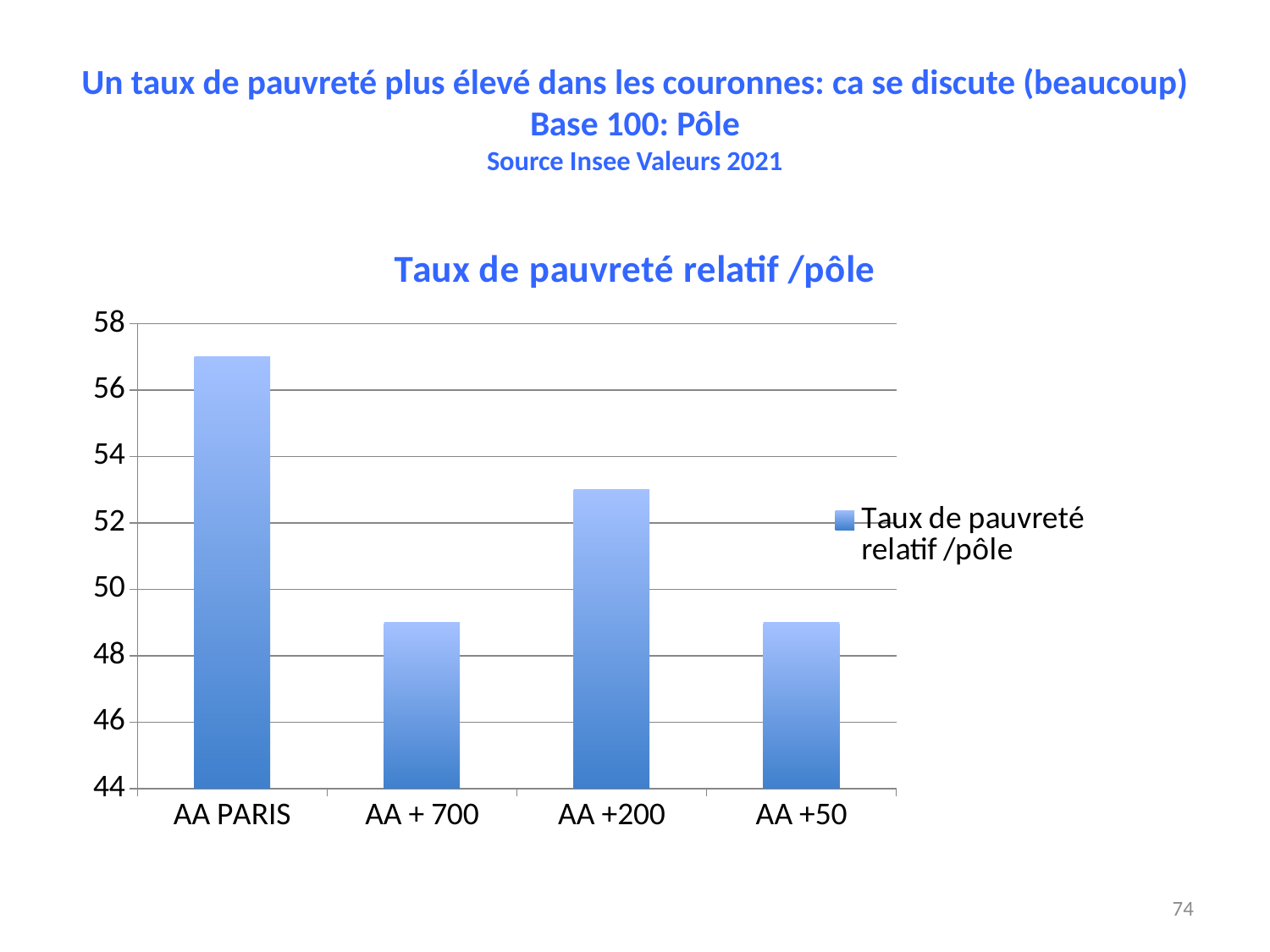
Is the value for AA +50 greater or less than 48? greater Is the value for AA +200 greater or less than 52? greater How many series does the legend list? 1 Which is larger, the value for AA PARIS or the value for AA +200? AA PARIS How many categories are shown on the x axis of the chart? 4 Which category has the highest value in the chart? AA PARIS What is the title of the chart? Taux de pauvreté relatif /pôle What is the name of the series shown in the legend? Taux de pauvreté relatif /pôle Is the value for AA PARIS greater or less than 56? greater Which is larger, the value for AA +200 or the value for AA +50? AA +200 What kind of chart is shown on the slide? bar chart